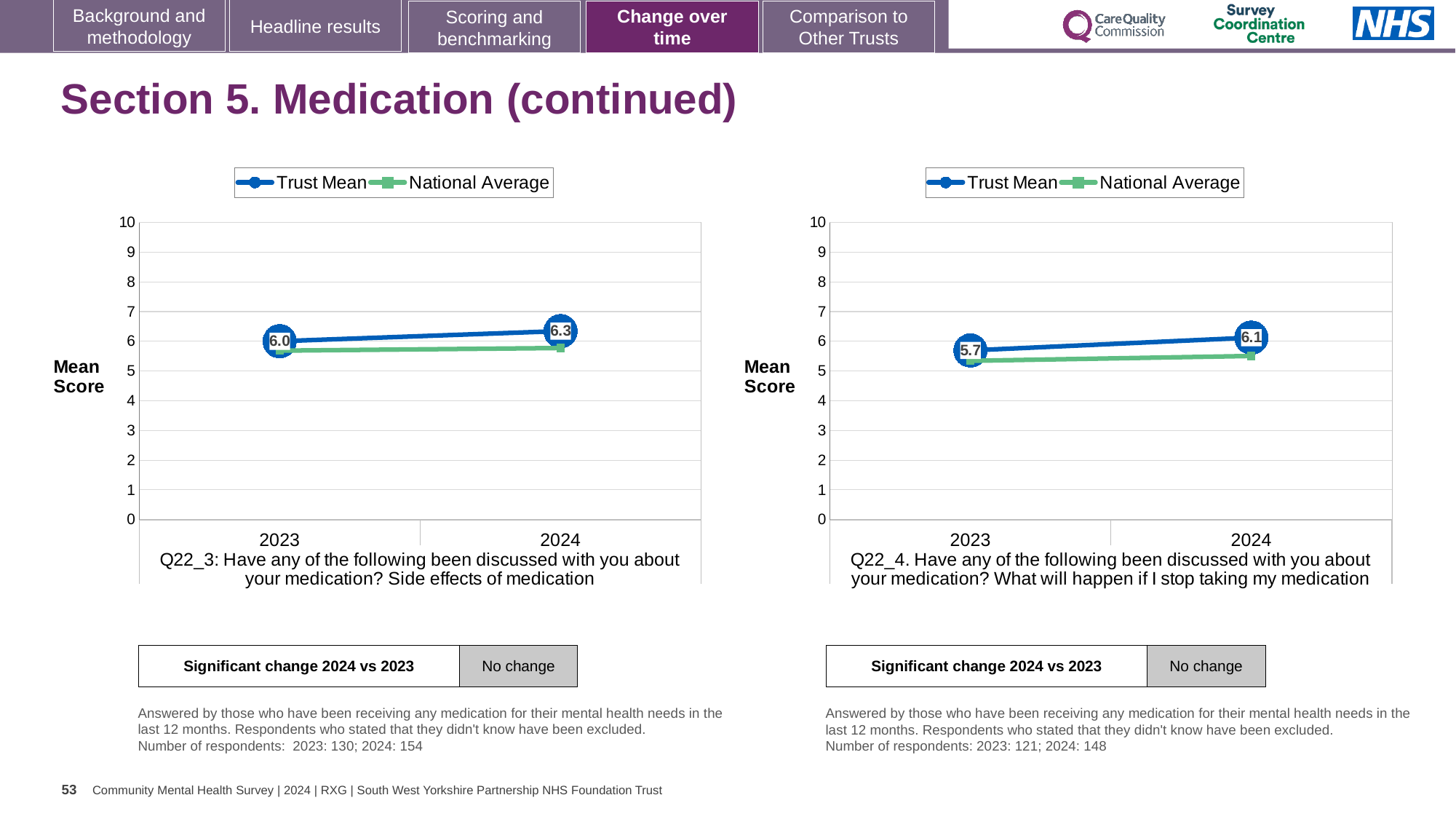
How many series does the legend of the right chart (Q22_4) list? 2 What kind of chart is the left chart (Q22_3)? line chart How many years are plotted on the x axis of the left chart (Q22_3)? 2 In the right chart (Q22_4), by how much did the Trust Mean change from 2023 to 2024? 0.4 In the right chart (Q22_4), does the Trust Mean rise or fall from 2023 to 2024? rise In the right chart (Q22_4), what is the Trust Mean score for 2023? 5.7 In the left chart (Q22_3), what is the Trust Mean score for 2023? 6.0 In the right chart (Q22_4), what is the Trust Mean score for 2024? 6.1 In the left chart (Q22_3), what is the Trust Mean score for 2024? 6.3 In the right chart (Q22_4), is the National Average value for 2023 greater or less than 6? less In the left chart (Q22_3), which series has the higher value in 2024, Trust Mean or National Average? Trust Mean In the left chart (Q22_3), by how much did the Trust Mean change from 2023 to 2024? 0.3